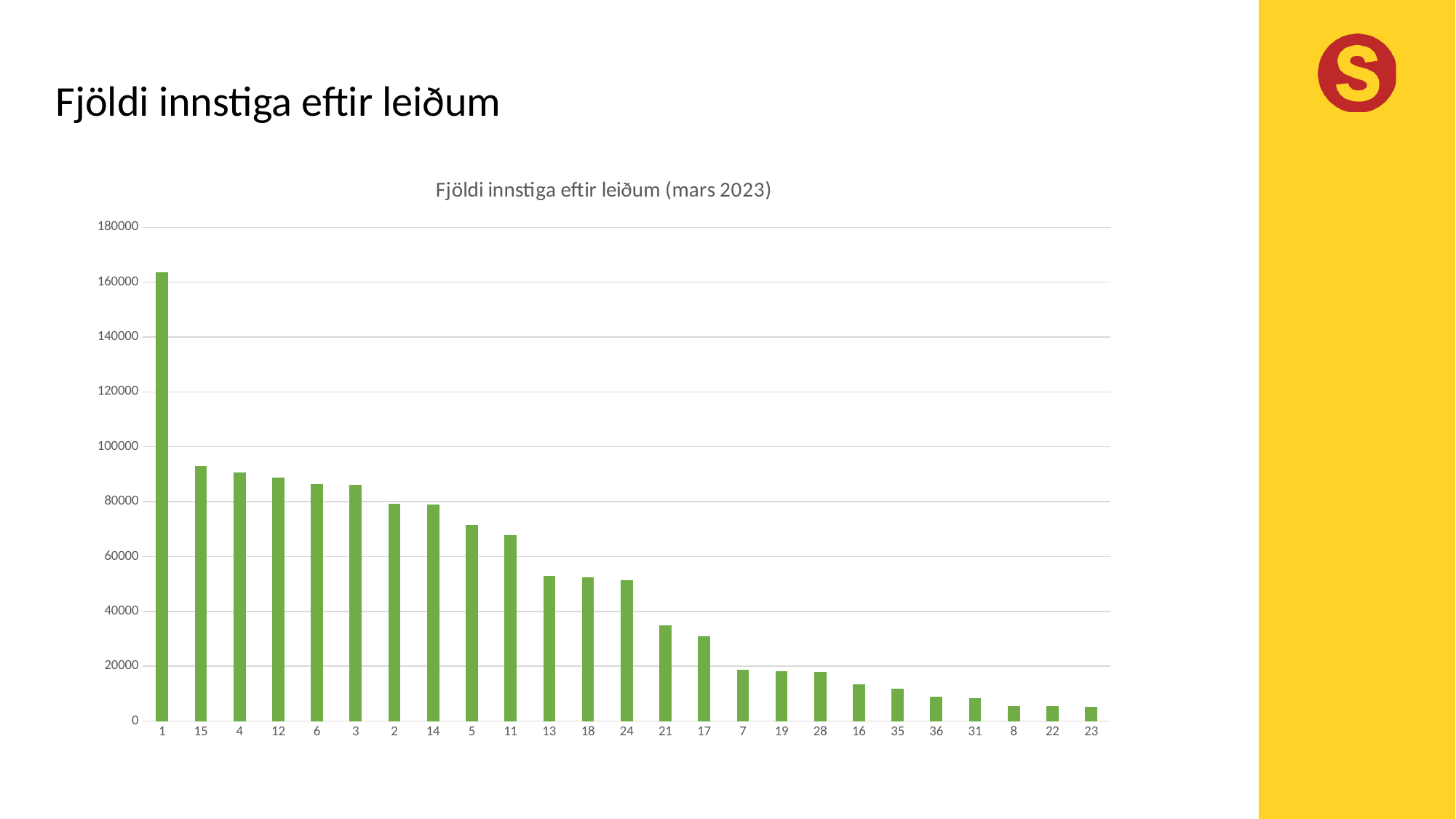
What kind of chart is shown on the slide? bar chart What is the title of the chart? Fjöldi innstiga eftir leiðum (mars 2023) Which has the larger value, route 11 or route 5? 5 Is the value for route 21 greater or less than 40000? less Is the value for route 5 greater or less than 60000? greater How many routes (categories) are plotted on the x axis? 25 Is the value for route 15 greater or less than 100000? less Which has the larger value, route 21 or route 17? 21 Which route has the highest number of boardings? 1 Do the values rise or fall moving from left to right along the x axis? fall